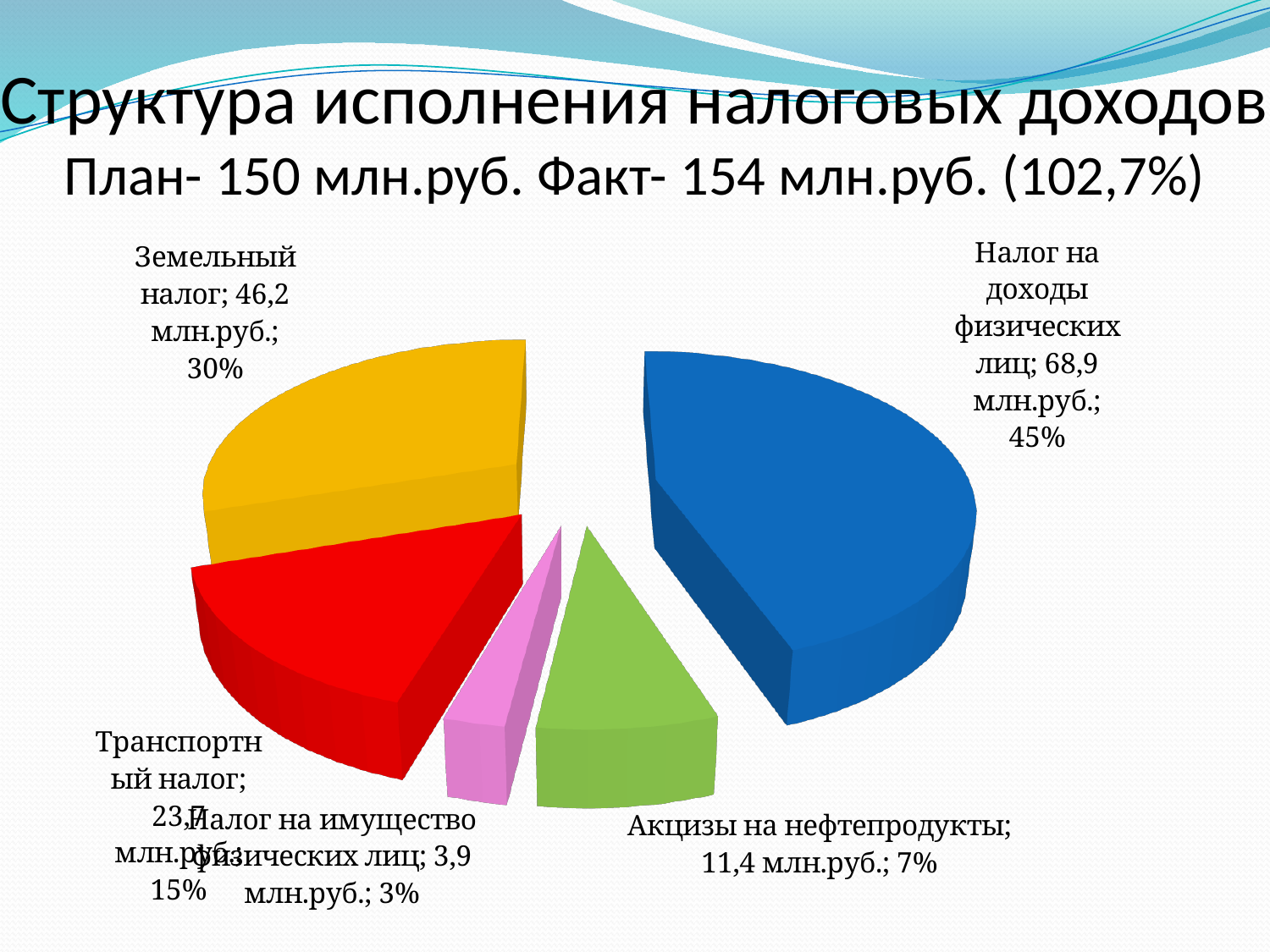
How many slices does the pie chart have? 5 Which category has the smallest slice of the pie? Налог на имущество физических лиц What kind of chart is shown on the slide? Pie chart What is the value for Земельный налог? 46,2 млн.руб. What is the value for Акцизы на нефтепродукты? 11,4 млн.руб. What share of the pie does Транспортный налог represent? 15% What share of the pie does Земельный налог represent? 30% What is the difference between the values for Налог на доходы физических лиц and Земельный налог? 22,7 млн.руб. Which is larger: Акцизы на нефтепродукты or Налог на имущество физических лиц? Акцизы на нефтепродукты Which category has the largest slice of the pie? Налог на доходы физических лиц What is the value for Налог на доходы физических лиц? 68,9 млн.руб. What is the value for Налог на имущество физических лиц? 3,9 млн.руб.